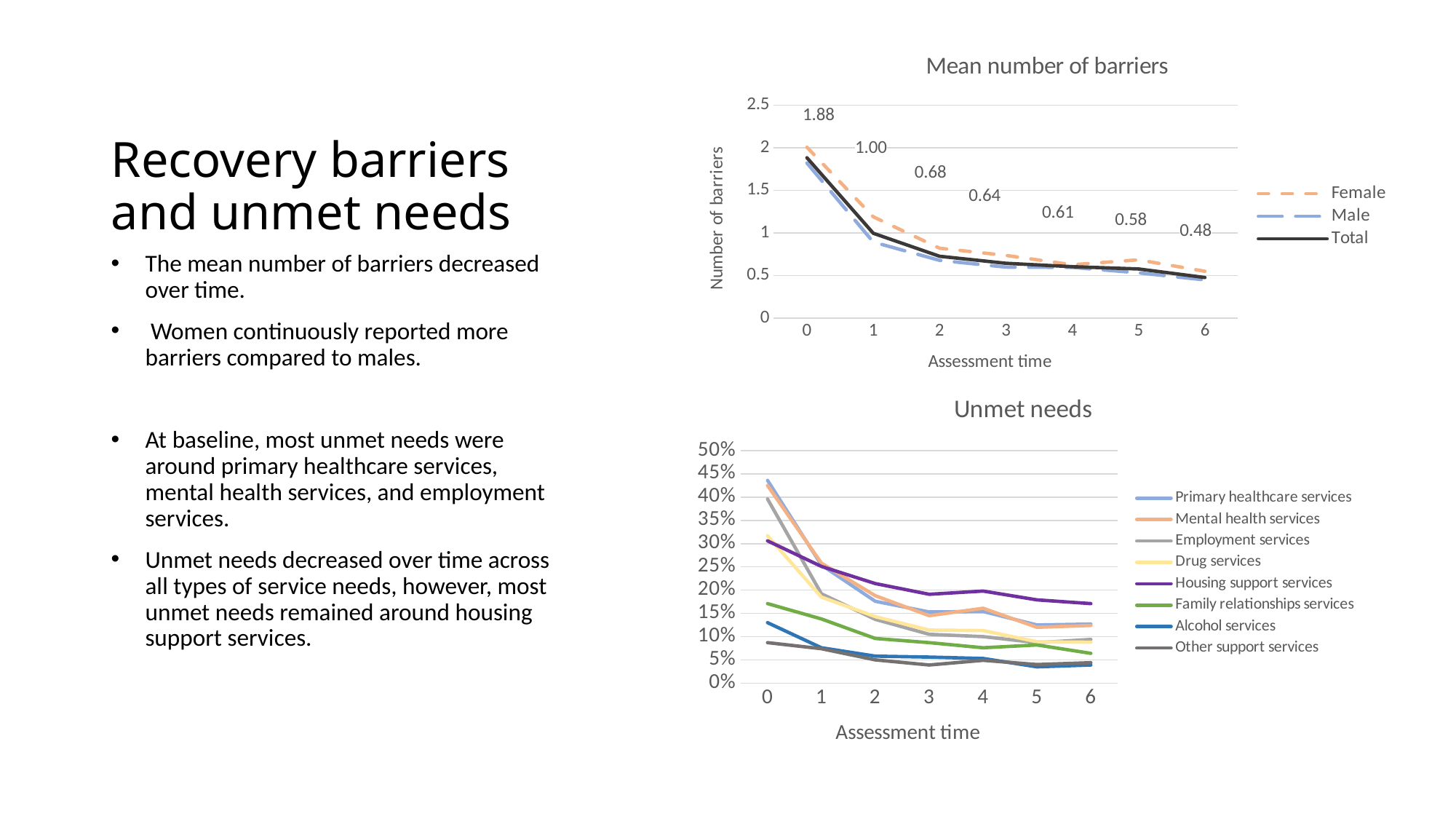
What kind of chart is the 'Unmet needs' chart? line chart In the 'Mean number of barriers' chart, what is the Total value at assessment time 3? 0.64 In the 'Mean number of barriers' chart, which series is consistently higher, Female or Male? Female In the 'Unmet needs' chart, which series has the highest value at assessment time 6? Housing support services In the 'Mean number of barriers' chart, what is the Total value at assessment time 6? 0.48 In the 'Unmet needs' chart, how many series does the legend list? 8 In the 'Mean number of barriers' chart, what is the Total value at assessment time 0? 1.88 In the 'Mean number of barriers' chart, do the Total values rise or fall as assessment time increases? fall In the 'Mean number of barriers' chart, how many series does the legend list? 3 In the 'Unmet needs' chart, is the value for Primary healthcare services at assessment time 0 greater or less than 40%? greater In the 'Unmet needs' chart, how many assessment time points are plotted on the x axis? 7 In the 'Mean number of barriers' chart, by how much did the Total value fall between assessment time 0 and assessment time 1? 0.88